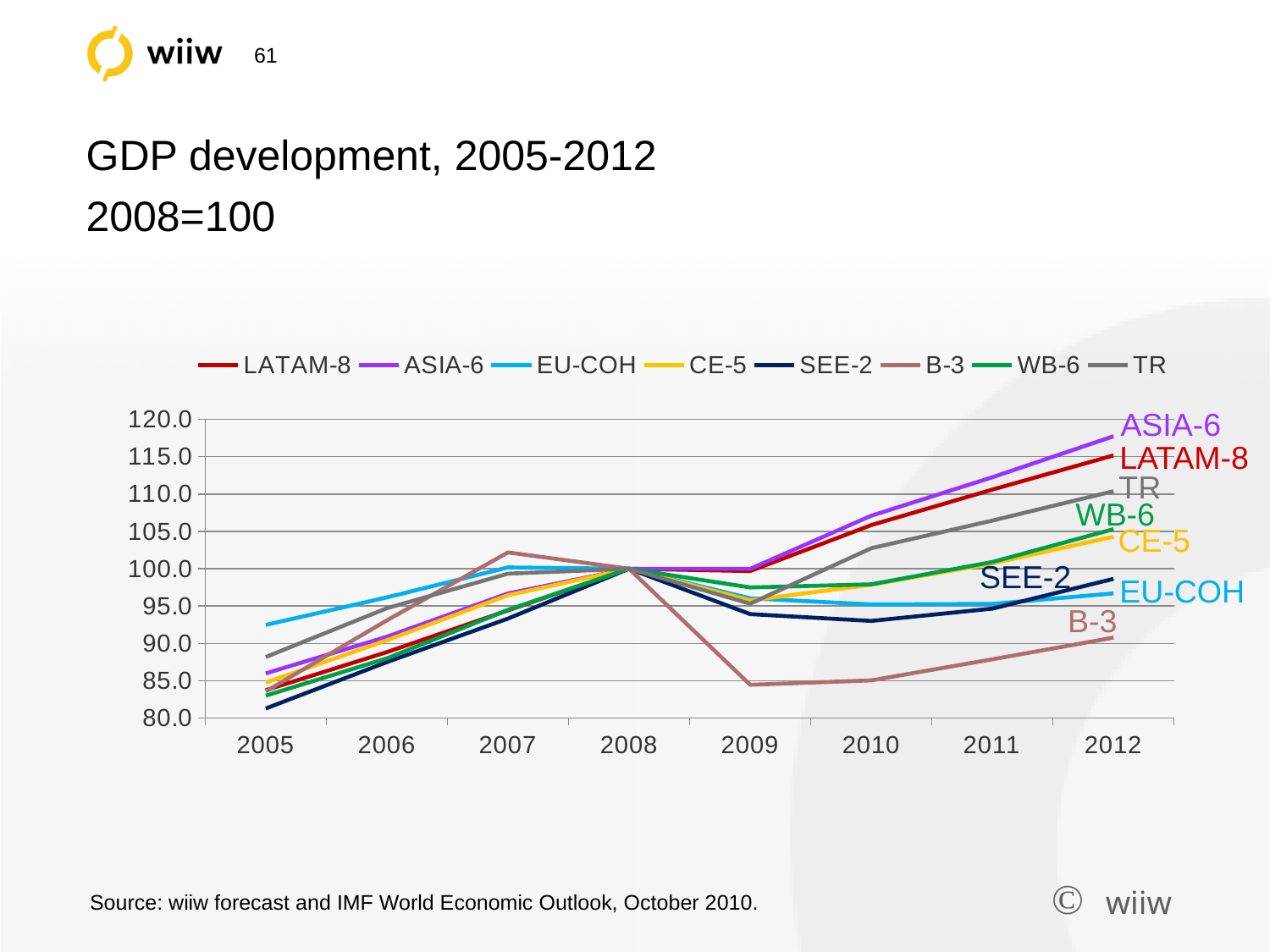
Which series has the highest value in 2005? EU-COH How many series does the legend list? 8 Which series has the lowest value in 2005? SEE-2 Which series has the lowest value in 2012? B-3 Is the value for B-3 in 2009 greater or less than 90? less Which series has the highest value in 2012? ASIA-6 How many years are shown on the x axis? 8 Does the B-3 line rise or fall from 2009 to 2012? rise What kind of chart is shown on the slide? line chart Is the value for ASIA-6 in 2012 greater or less than 115? greater What is the value for LATAM-8 in 2008? 100.0 In 2009, which is larger, the value for SEE-2 or the value for B-3? SEE-2